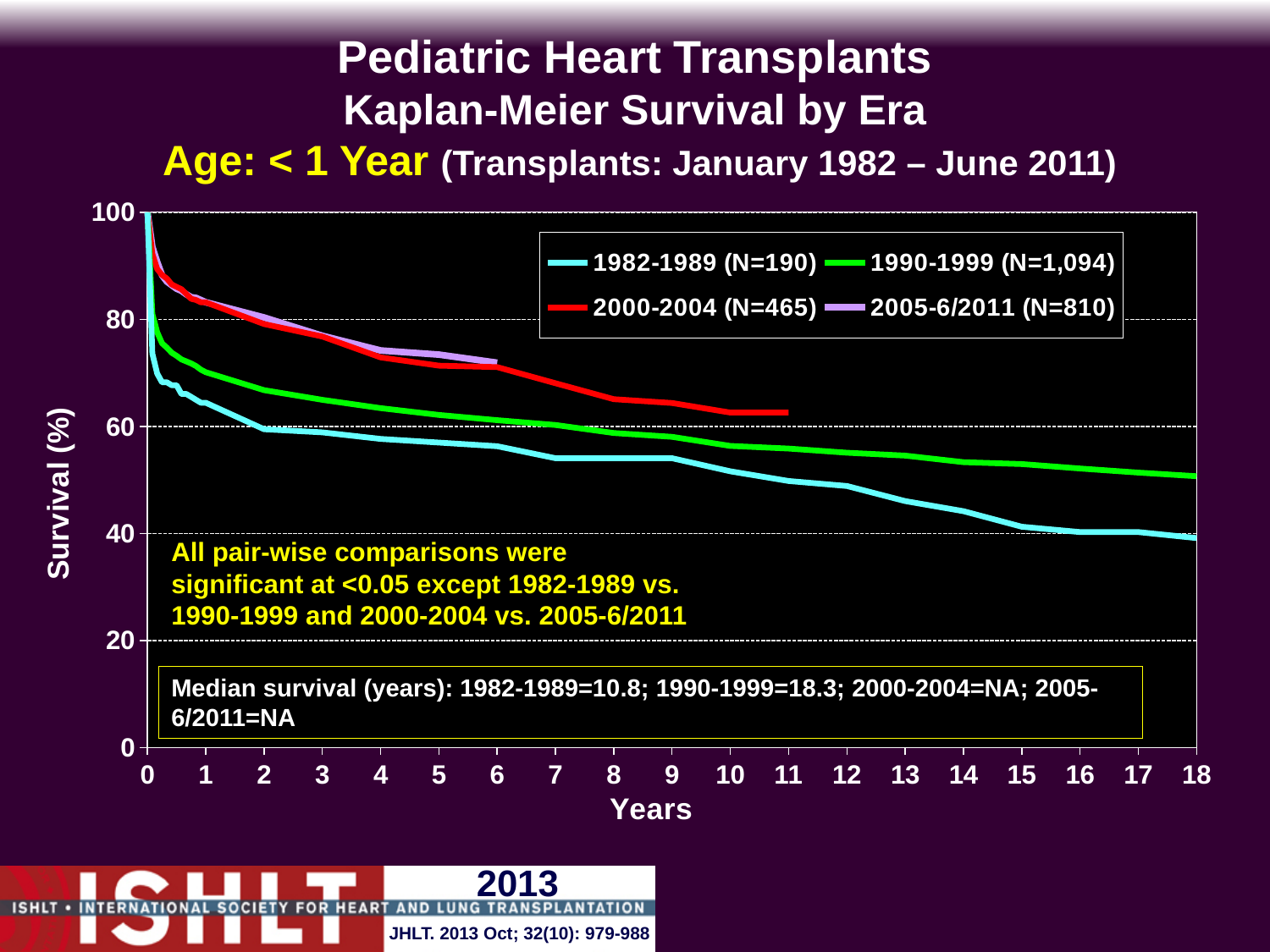
What median survival in years is given for the 1990-1999 era? 18.3 Which era has the highest survival at 10 years? 2000-2004 Do the survival curves rise or fall as years increase? fall At 5 years, which era has higher survival: 1982-1989 or 1990-1999? 1990-1999 How many series does the legend list? 4 Which era has the lowest survival at 10 years? 1982-1989 According to the legend, what is the N for the 1990-1999 era? N=1,094 Is the survival value for the 2005-6/2011 era at 5 years greater or less than 80? less Is the survival value for the 2000-2004 era at 5 years greater or less than 60? greater What kind of chart is shown on the slide? line chart Is the survival value for the 1982-1989 era at 10 years greater or less than 60? less